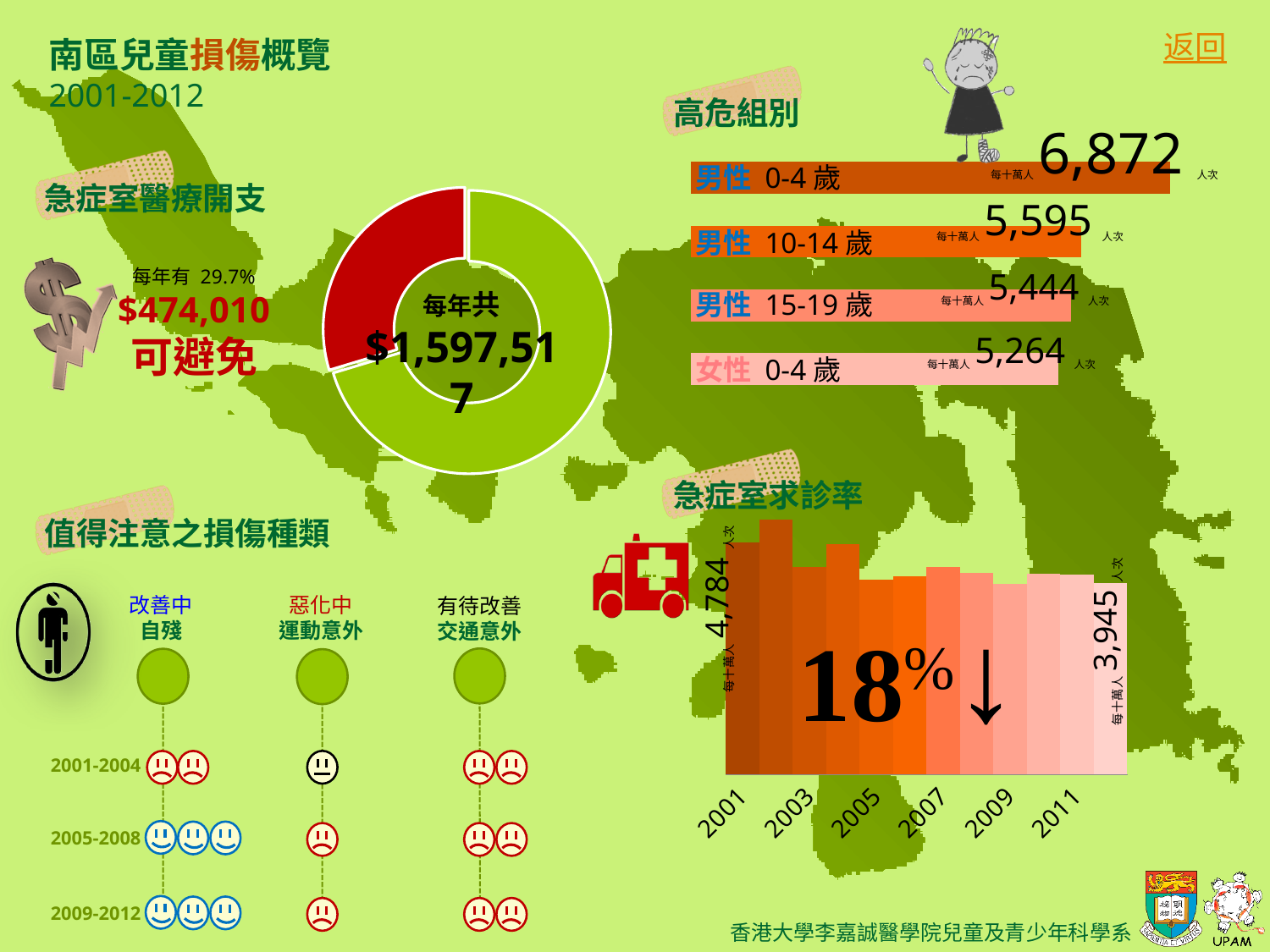
In the 急症室求診率 chart, what is the overall percentage change shown from 2001 to 2012? 18% decrease How many groups are shown in the 高危組別 chart? 4 In the 急症室求診率 chart, what is the value for 2001? 4,784 In the 急症室醫療開支 chart, what amount per year is labelled as 可避免 (avoidable)? $474,010 What kind of chart is used for 急症室醫療開支? Donut (pie) chart In the 高危組別 chart, which group has the lowest value? 女性 0-4 歲 In the 高危組別 chart, which group has the highest value? 男性 0-4 歲 In the 高危組別 chart, what is the value for 男性 0-4 歲? 6,872 In the 高危組別 chart, what is the difference between 男性 0-4 歲 and 女性 0-4 歲? 1,608 In the 高危組別 chart, what is the value for 女性 0-4 歲? 5,264 In the 急症室醫療開支 chart, what percentage share of the annual expenditure is shown as avoidable? 29.7% In the 急症室醫療開支 chart, what is the total annual amount shown in the centre of the donut? $1,597,517